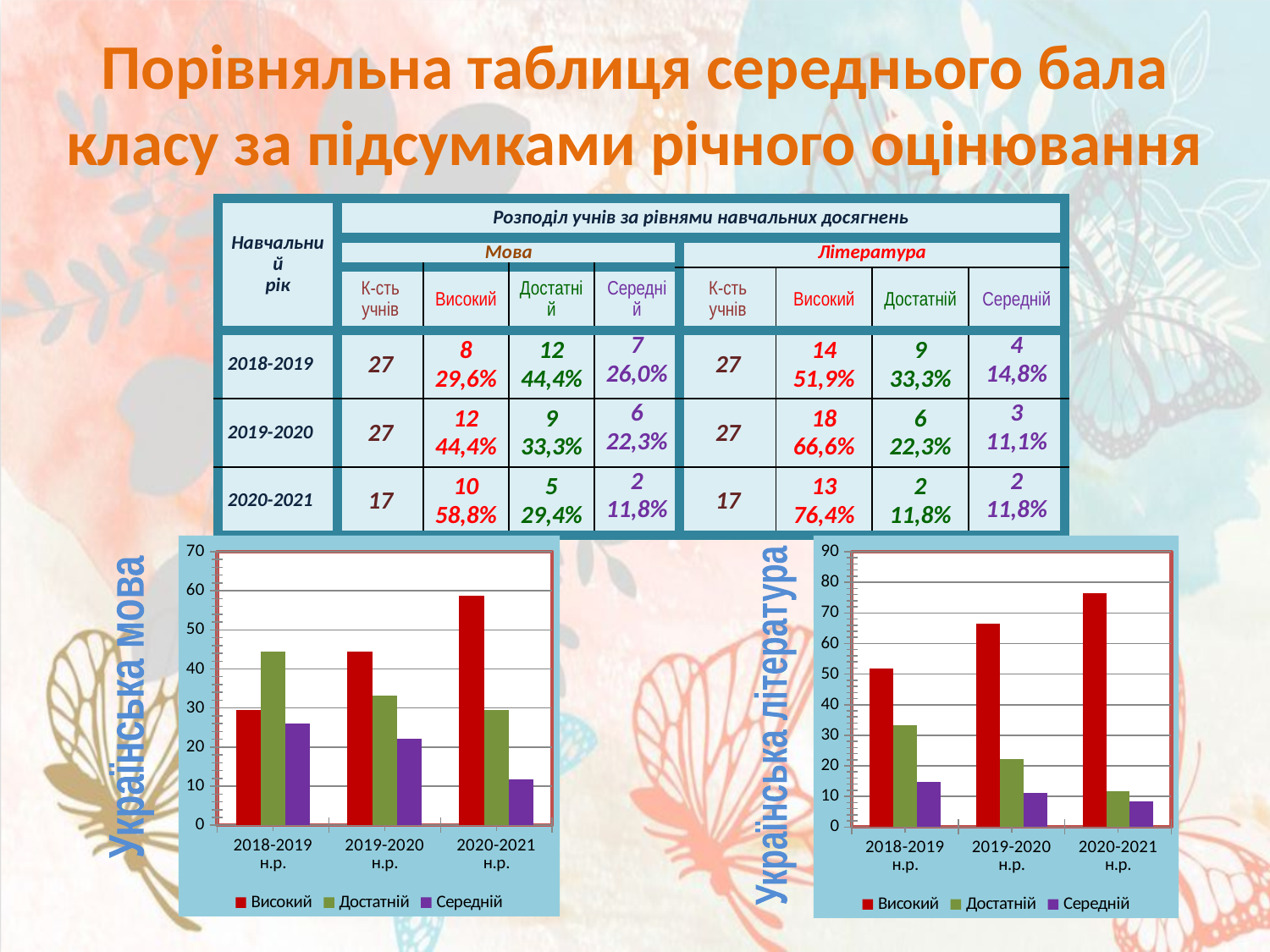
How many series does the legend of the 'Українська література' chart list? 3 What kind of chart is the 'Українська мова' chart on the left? bar chart How many school-year categories are shown on the x axis of the 'Українська мова' chart? 3 In the 'Українська мова' chart, for 2018-2019, which is larger: 'Високий' or 'Достатній'? Достатній In the 'Українська мова' chart, does the 'Високий' series rise or fall from 2018-2019 to 2020-2021? rises In the 'Українська мова' chart, which school year has the lowest 'Середній' bar? 2020-2021 н.р. In the 'Українська література' chart, is the 'Високий' value for 2019-2020 greater or less than 60? greater What are the three legend entries of the 'Українська література' chart? Високий, Достатній, Середній In the 'Українська література' chart, is the 'Достатній' value for 2020-2021 greater or less than 20? less In the 'Українська мова' chart, is the 'Високий' value for 2020-2021 greater or less than 50? greater In the 'Українська література' chart, which school year has the highest 'Високий' bar? 2020-2021 н.р. In the 'Українська література' chart, does the 'Достатній' series rise or fall across the three school years? falls